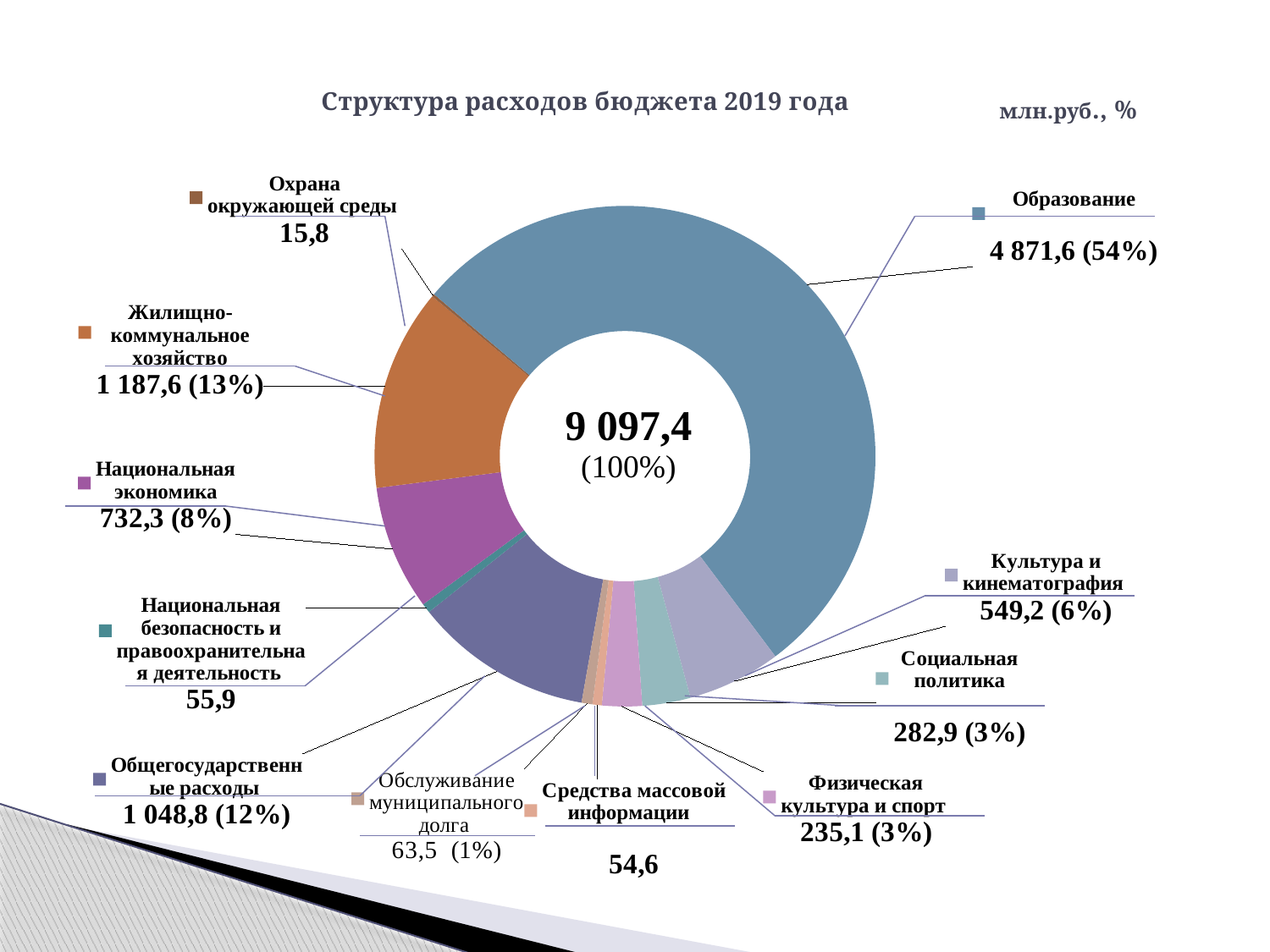
Which category has the smallest value in the chart? Охрана окружающей среды What is the difference between Социальная политика and Физическая культура и спорт? 47,8 What is the difference between Образование and Жилищно-коммунальное хозяйство? 3 684,0 What kind of chart is shown on the slide? doughnut chart What is the total budget expenditure shown in the centre of the chart? 9 097,4 What is the value for Средства массовой информации? 54,6 How many expenditure categories are shown in the chart? 11 What is the value for Образование in the chart? 4 871,6 Which category has the largest share of the budget expenditure? Образование What share of the total does Культура и кинематография account for? 6% Which is larger, Общегосударственные расходы or Национальная экономика? Общегосударственные расходы What is the value for Жилищно-коммунальное хозяйство? 1 187,6